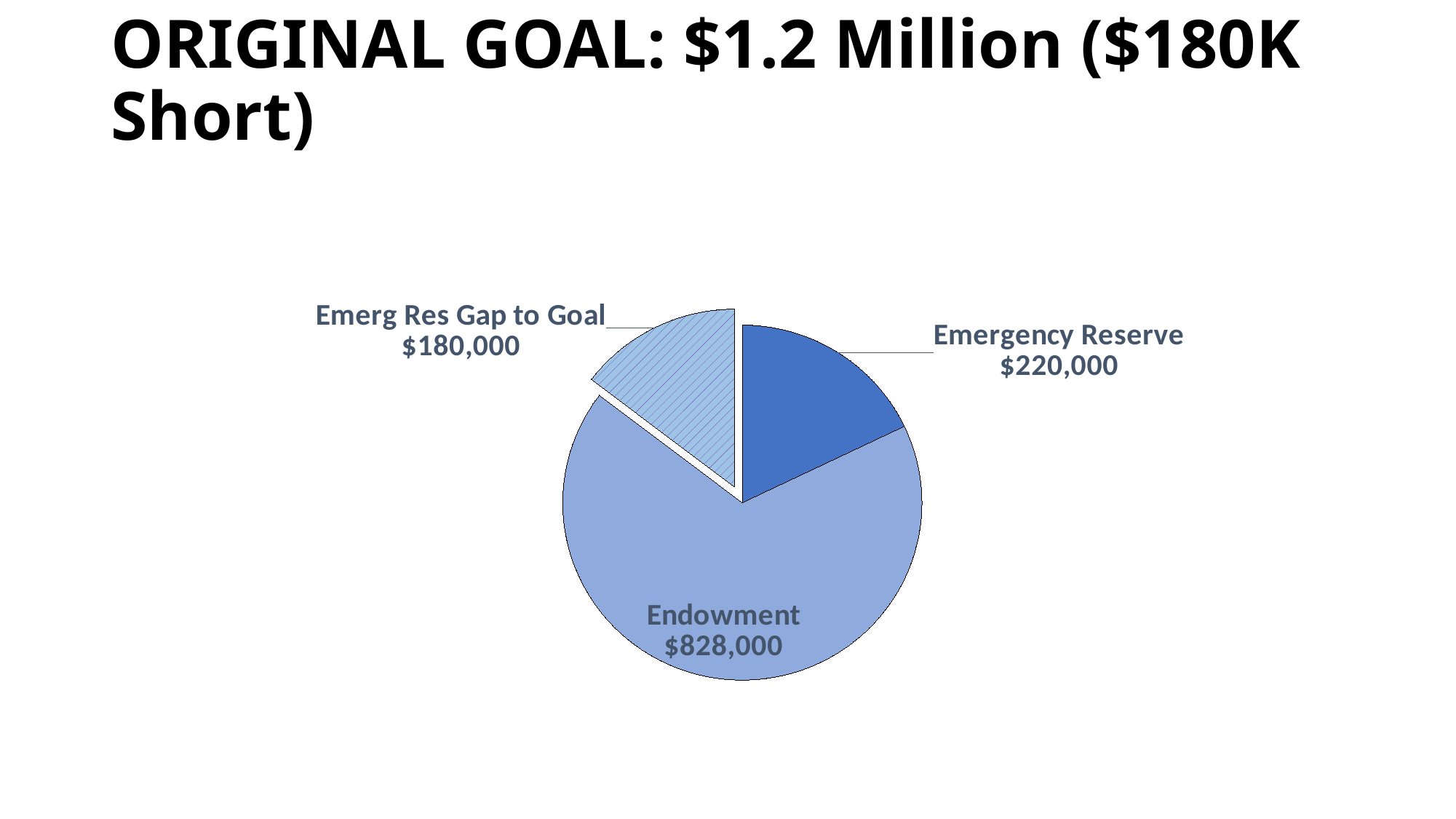
What is the total of all three slices in the pie chart? $1,228,000 How many slices does the pie chart have? 3 Which slice is drawn with a hatched (striped) pattern and pulled out from the pie? Emerg Res Gap to Goal What kind of chart is shown on the slide? Pie chart Which slice of the pie is the largest? Endowment What is the value of the Endowment slice? $828,000 What is the value of the Emerg Res Gap to Goal slice? $180,000 What is the value of the Emergency Reserve slice? $220,000 What is the difference between the Endowment and Emergency Reserve values? $608,000 What is the difference between the Emergency Reserve and Emerg Res Gap to Goal values? $40,000 Which is larger, Emergency Reserve or Emerg Res Gap to Goal? Emergency Reserve Which slice of the pie is the smallest? Emerg Res Gap to Goal